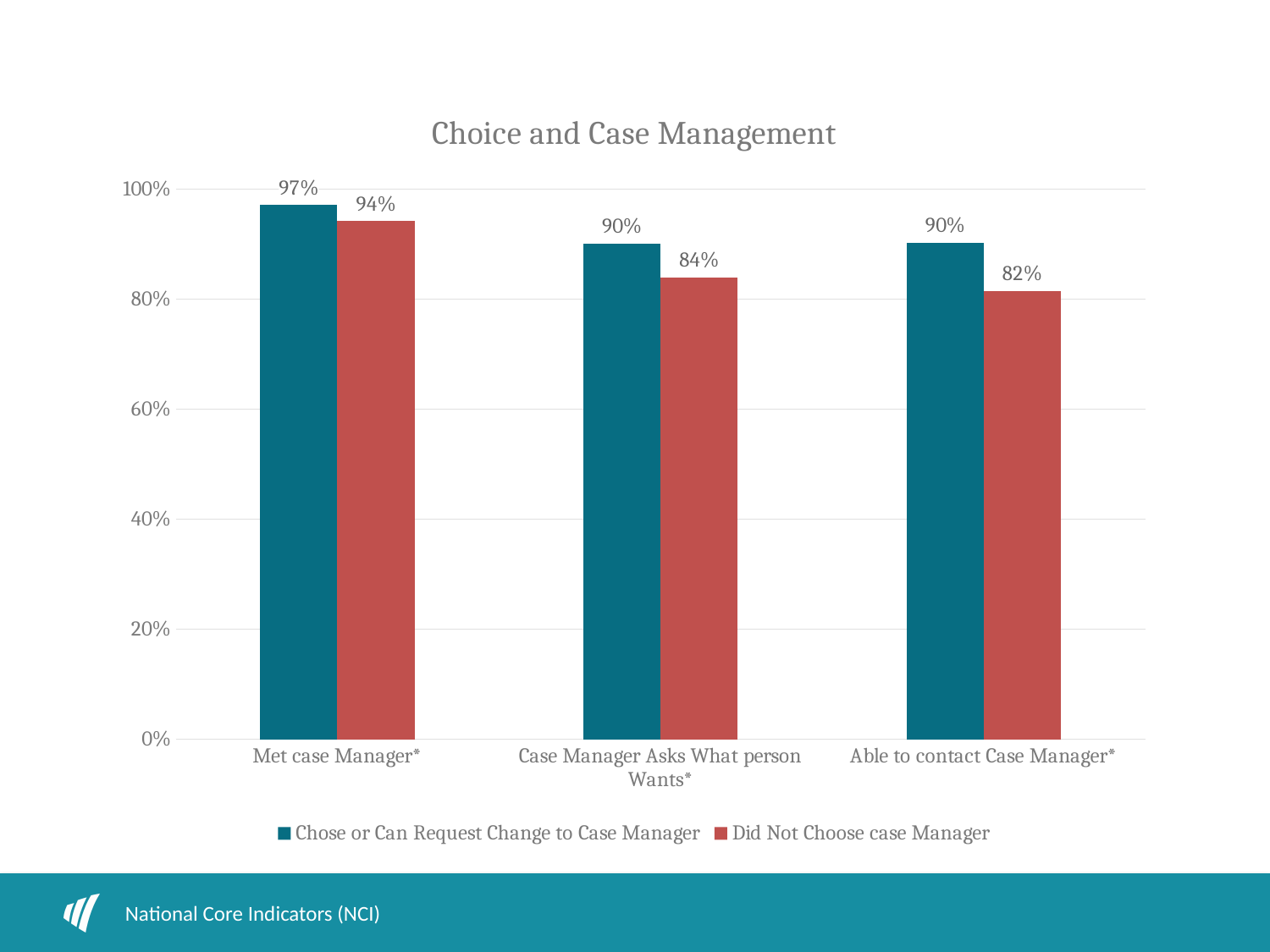
Is the value for "Able to contact Case Manager*" in the "Did Not Choose case Manager" series greater or less than 80%? greater Which category has the lowest value in the "Did Not Choose case Manager" series? Able to contact Case Manager* What is the difference between the two series for "Case Manager Asks What person Wants*"? 6% What is the value for "Met case Manager*" in the "Chose or Can Request Change to Case Manager" series? 97% Which category has the highest value in the "Did Not Choose case Manager" series? Met case Manager* For "Met case Manager*", which series has the larger value? Chose or Can Request Change to Case Manager What is the difference between the two series for "Able to contact Case Manager*"? 8% What is the value for "Able to contact Case Manager*" in the "Did Not Choose case Manager" series? 82% What type of chart is shown on the slide? Bar chart How many series does the legend list? 2 What is the value for "Case Manager Asks What person Wants*" in the "Did Not Choose case Manager" series? 84% How many categories are shown on the x axis? 3